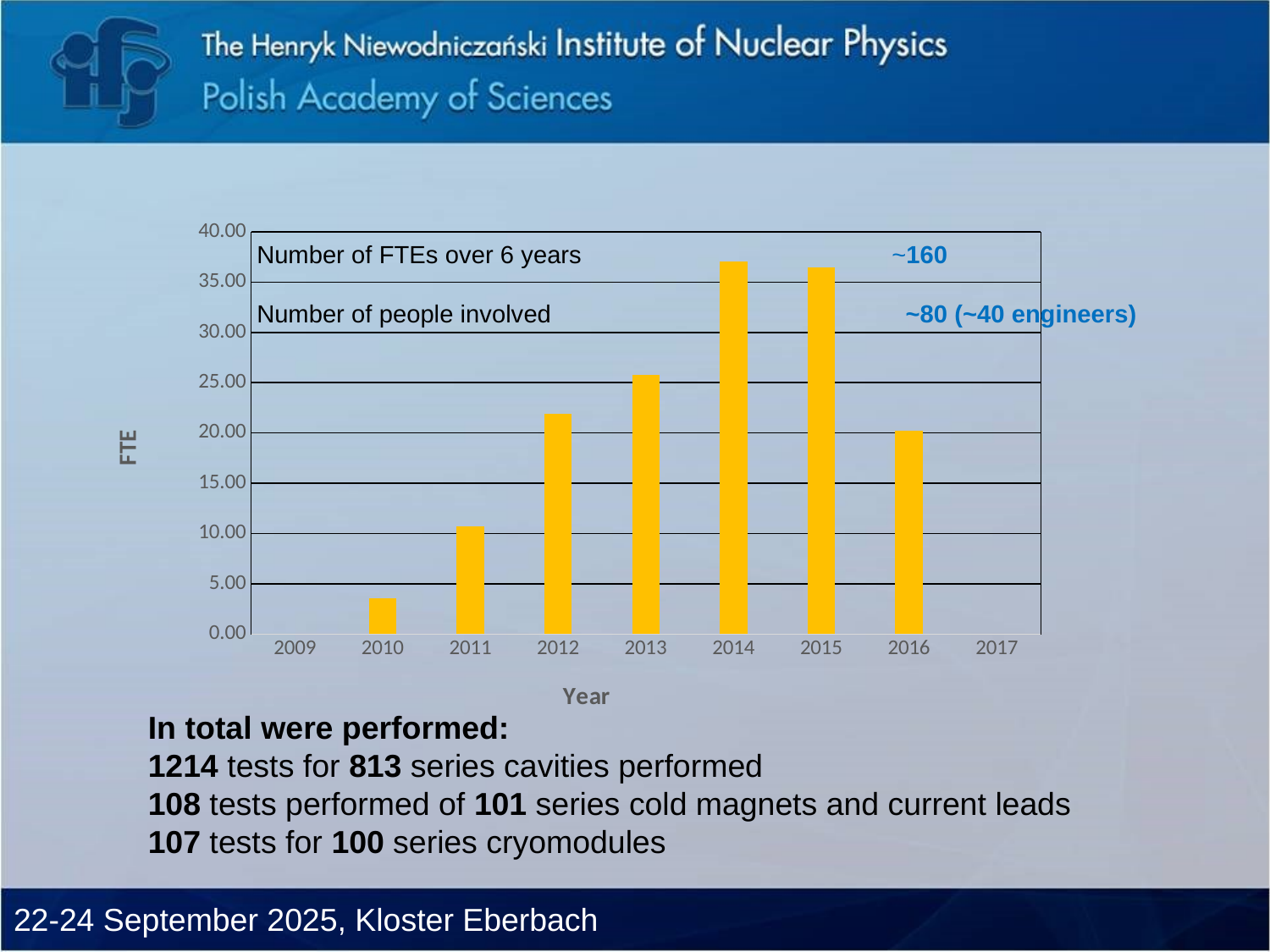
Which year has the larger FTE value, 2011 or 2012? 2012 How many years are labelled on the x axis of the chart? 9 Is the FTE value for 2012 greater or less than 20.00? greater Which year has the lowest FTE bar on the chart? 2010 Is the FTE value for 2013 greater or less than 30.00? less Which year has the larger FTE value, 2013 or 2016? 2013 Do the FTE values rise or fall from 2010 to 2014? rise What is the label of the vertical axis of the chart? FTE Is the FTE value for 2011 greater or less than 15.00? less What kind of chart is shown on the slide? bar chart